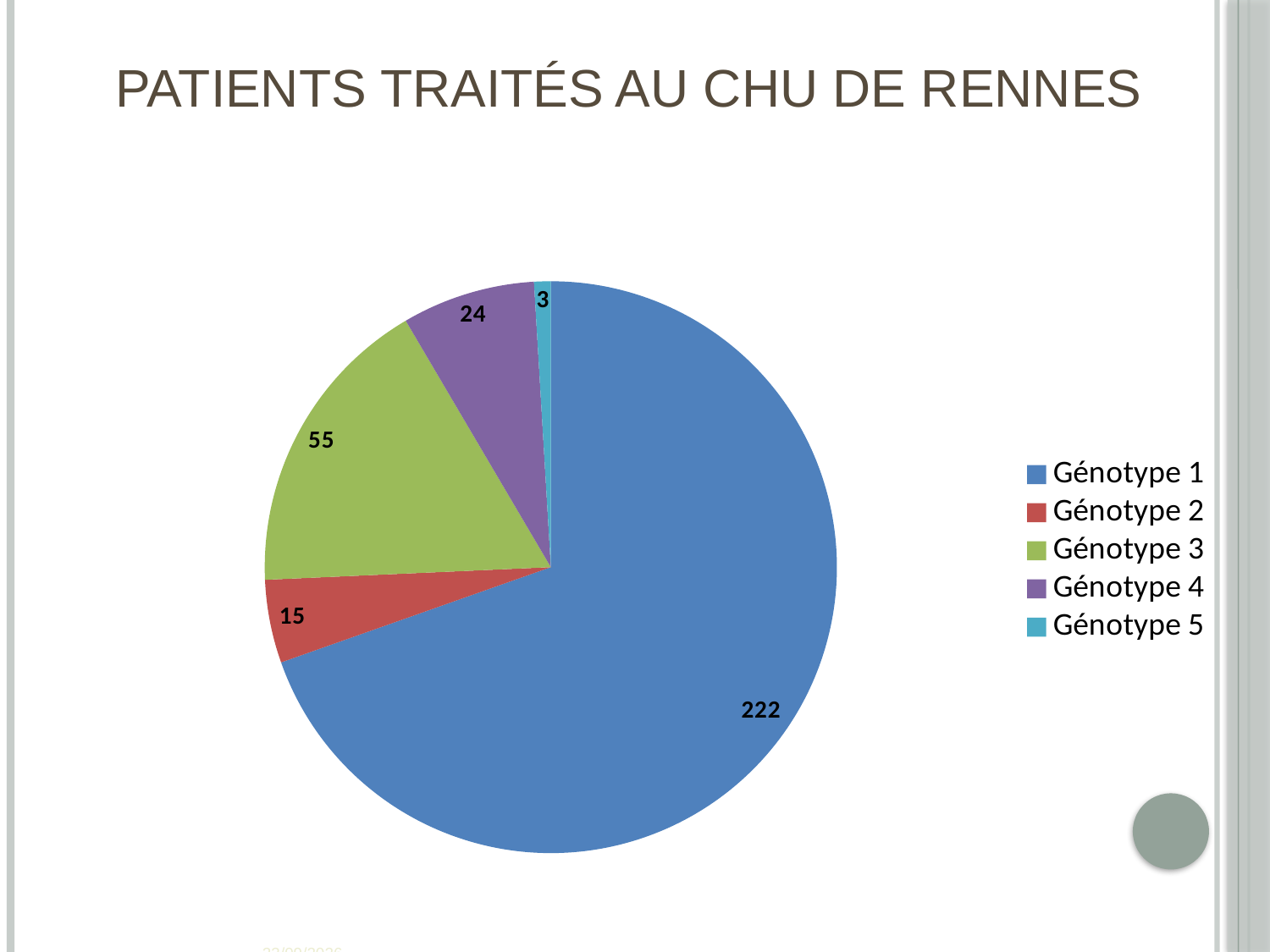
Which genotype has the smallest slice? Génotype 5 How many slices does the pie chart have? 5 What is the total of all the values shown in the pie chart? 319 What is the value for Génotype 5? 3 What is the value for Génotype 1? 222 Which is larger, the value for Génotype 4 or the value for Génotype 2? Génotype 4 What is the title of the slide? PATIENTS TRAITÉS AU CHU DE RENNES What is the value for Génotype 3? 55 Which genotype has the largest slice? Génotype 1 What is the value for Génotype 4? 24 What is the difference between the values for Génotype 3 and Génotype 2? 40 What type of chart is shown on the slide? pie chart